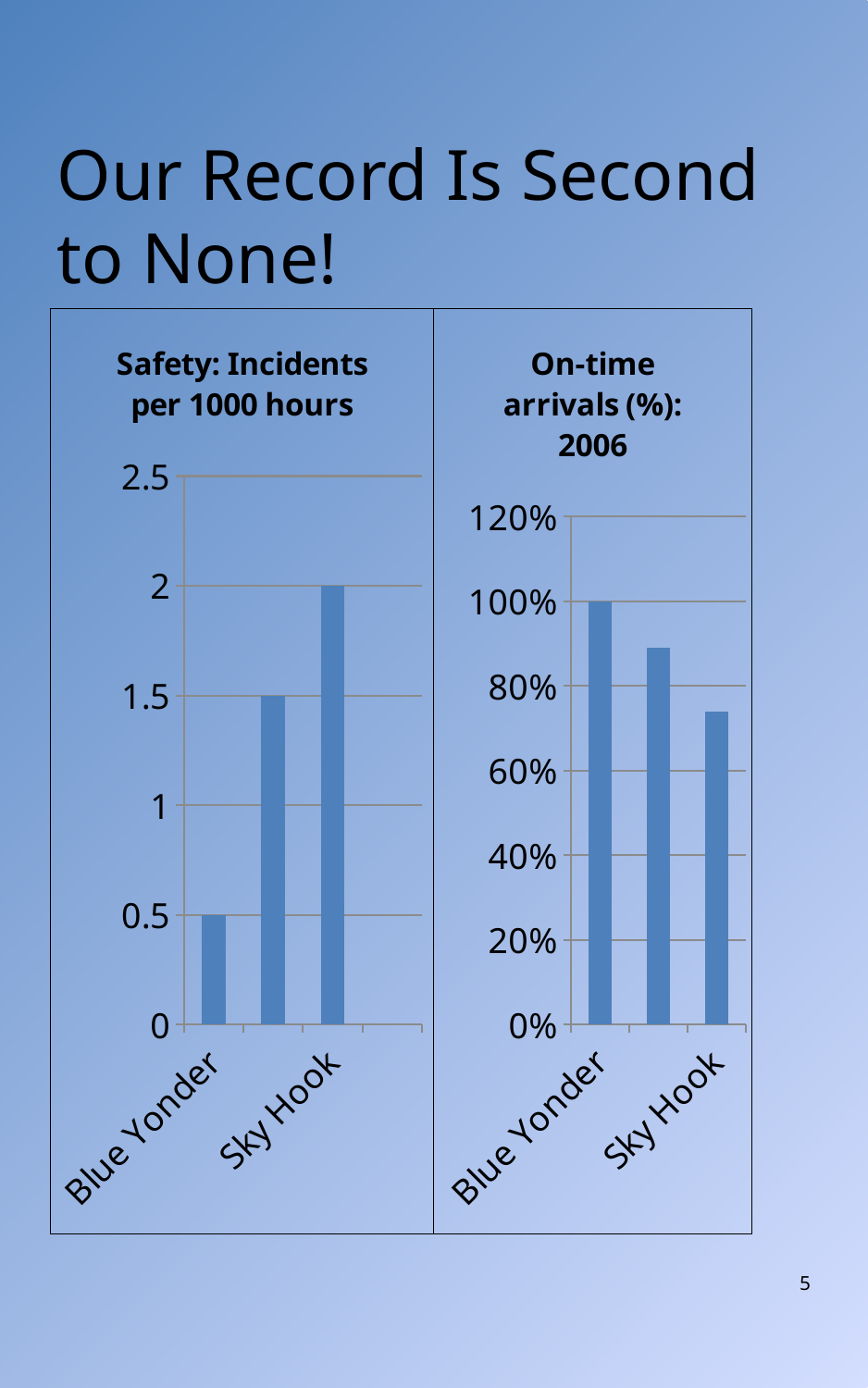
In the 'Safety: Incidents per 1000 hours' chart, what is the value for Blue Yonder? 0.5 How many bars are plotted in the 'Safety: Incidents per 1000 hours' chart? 3 What is the title of the chart on the right side of the slide? On-time arrivals (%): 2006 In the 'Safety: Incidents per 1000 hours' chart, which labelled category has the lowest value? Blue Yonder How many charts are shown on the slide? 2 In the 'On-time arrivals (%): 2006' chart, which labelled category has the highest value? Blue Yonder In the 'On-time arrivals (%): 2006' chart, what is the value for Blue Yonder? 100% What kind of chart is the 'Safety: Incidents per 1000 hours' chart? bar chart In the 'On-time arrivals (%): 2006' chart, do the values rise or fall from left to right? fall In the 'Safety: Incidents per 1000 hours' chart, do the values rise or fall from left to right? rise How many bars are plotted in the 'On-time arrivals (%): 2006' chart? 3 In the 'On-time arrivals (%): 2006' chart, is the value for Blue Yonder greater or less than 80%? greater